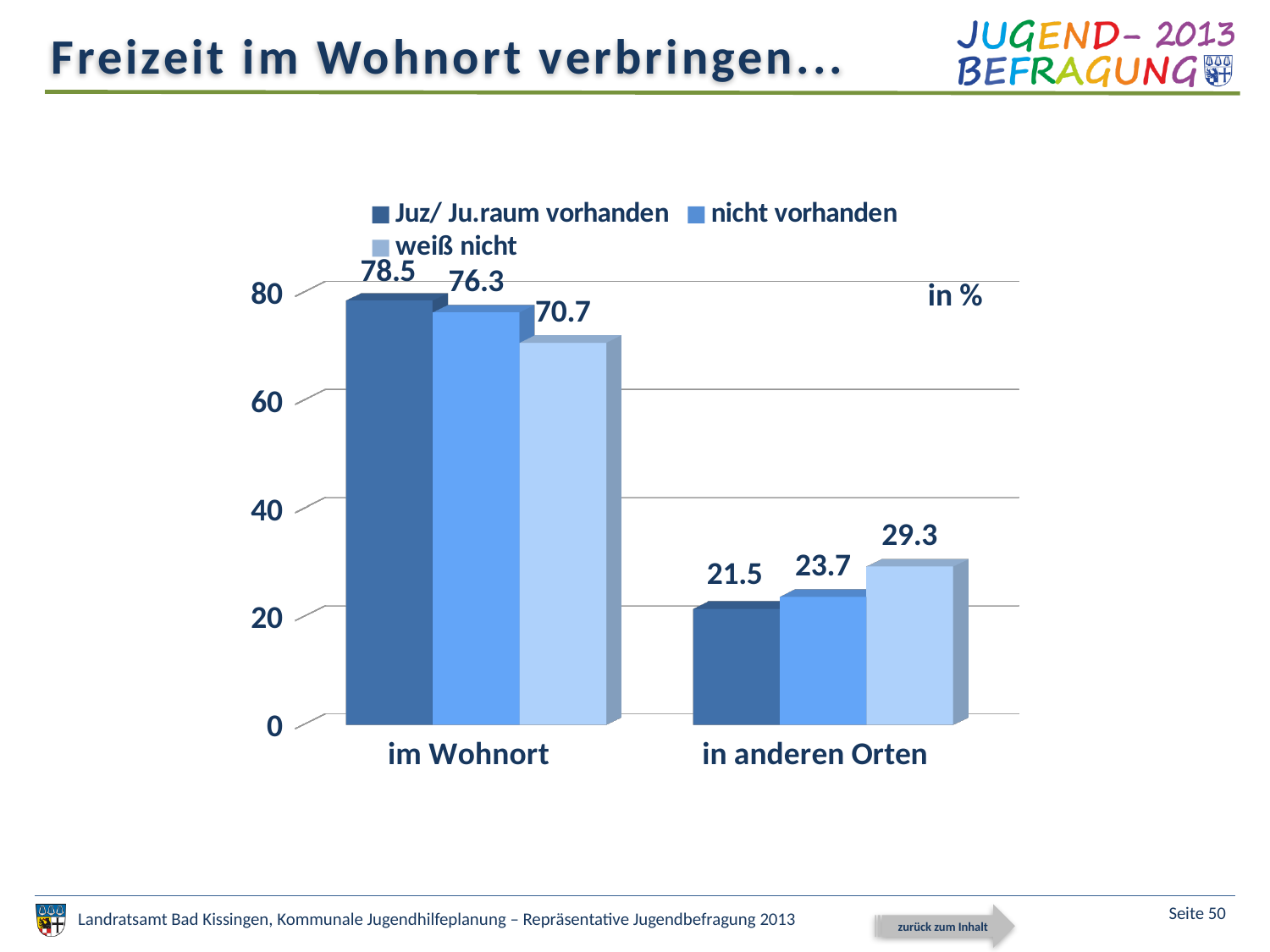
Which series has the highest value in the "in anderen Orten" category? weiß nicht What is the value for "weiß nicht" in the "in anderen Orten" category? 29.3 What unit is indicated for the values in the chart? % Which series has the lowest value in the "im Wohnort" category? weiß nicht What is the value for "Juz/ Ju.raum vorhanden" in the "im Wohnort" category? 78.5 Which is larger: the "nicht vorhanden" value for "in anderen Orten" or the "Juz/ Ju.raum vorhanden" value for "in anderen Orten"? nicht vorhanden How many categories are shown on the x axis? 2 How many series does the legend list? 3 Is the value for "weiß nicht" in the "im Wohnort" category greater or less than 60? greater What is the difference between the "Juz/ Ju.raum vorhanden" values for "im Wohnort" and "in anderen Orten"? 57 What kind of chart is shown on the slide? bar chart What is the value for "nicht vorhanden" in the "im Wohnort" category? 76.3